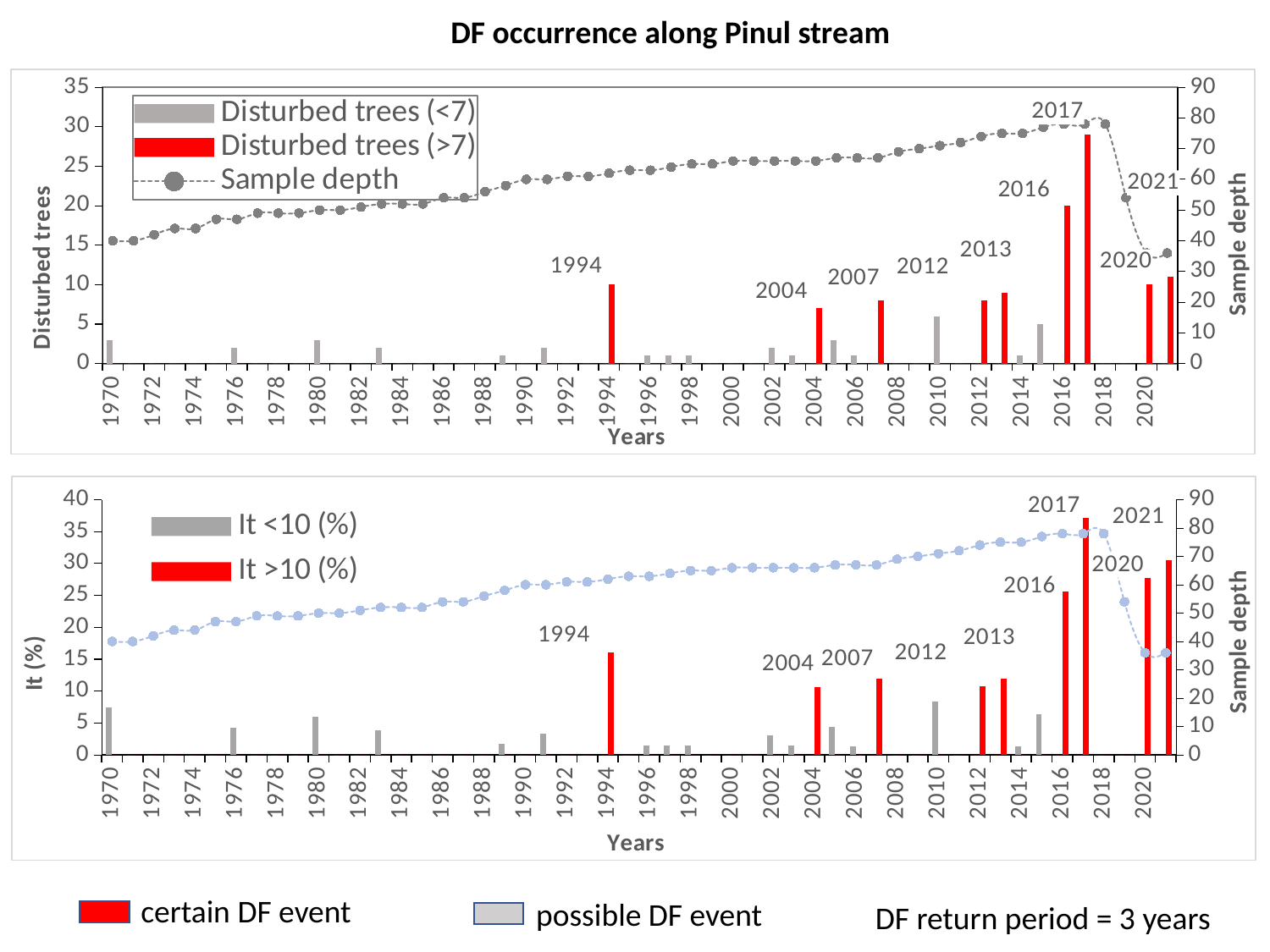
In the top chart, is the red bar for 2017 greater or less than 25 disturbed trees? greater How many red bars (certain DF events) are shown in the top chart? 9 In the top chart, which year has the tallest red bar (Disturbed trees >7)? 2017 In the top chart, does the sample depth line rise or fall from 1970 to 2017? rise In the bottom chart, is the red bar for 1994 greater or less than 10%? greater In the bottom chart, which year has the tallest red bar (It >10 %)? 2017 What is the title shown above the charts on the slide? DF occurrence along Pinul stream In the top chart, which red bar is taller, 2016 or 2013? 2016 What kind of chart is the top chart on the slide? bar chart with a line How many series does the legend of the bottom chart list? 2 How many series does the legend of the top chart list? 3 In the bottom chart, which red bar is taller, 2020 or 2021? 2021